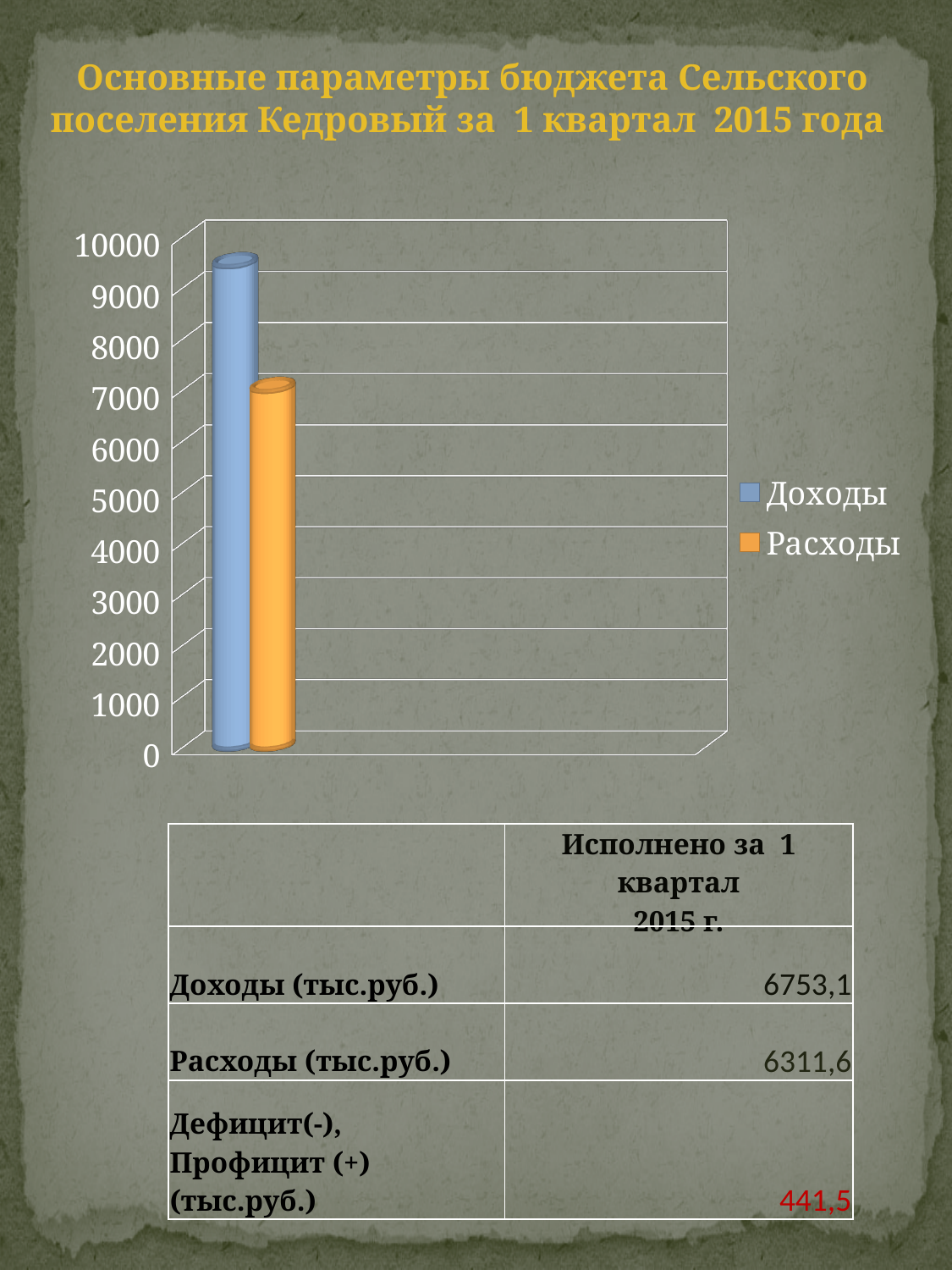
Which series is represented by the blue bar in the chart? Доходы How many series does the chart legend list? 2 Which series has the shortest bar in the chart? Расходы Which series has the highest bar in the chart? Доходы What is the maximum value shown on the chart's vertical axis? 10000 Is the value of the Расходы bar greater or less than 6000? greater What kind of chart is shown on the slide? bar chart Which series has the taller bar in the chart, Доходы or Расходы? Доходы How many bars are plotted in the chart? 2 Is the value of the Доходы bar greater or less than 9000? greater Is the value of the Расходы bar greater or less than 8000? less Which series is represented by the orange bar in the chart? Расходы